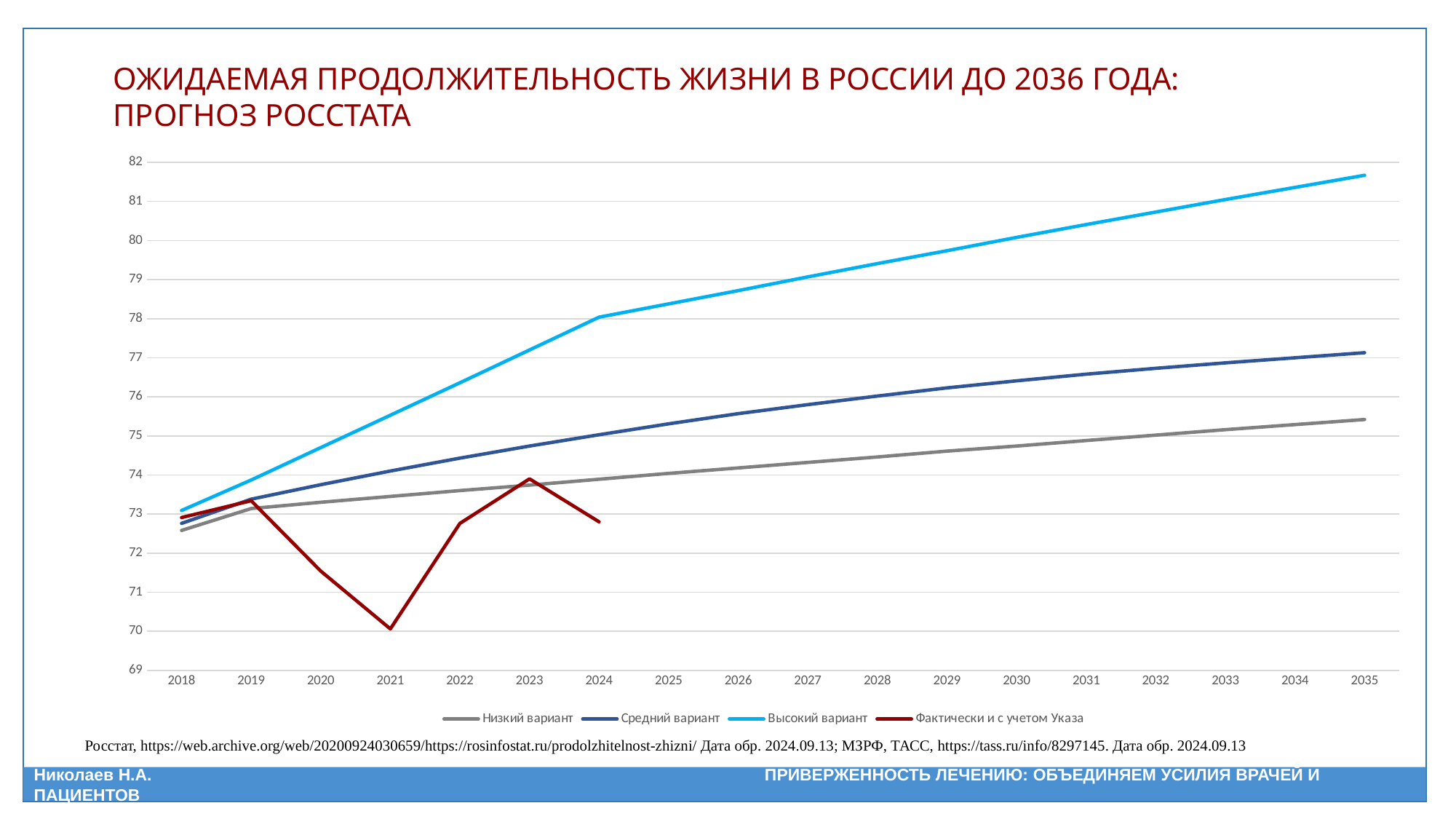
Which series has the highest value in 2035? Высокий вариант Is the value for 'Средний вариант' in 2035 greater or less than 78? less In which year does the series 'Фактически и с учетом Указа' reach its highest value? 2023 How many years are shown on the x axis? 18 What colour is the line for 'Фактически и с учетом Указа'? dark red In 2021, which is larger: 'Низкий вариант' or 'Фактически и с учетом Указа'? Низкий вариант In which year does the series 'Фактически и с учетом Указа' reach its lowest value? 2021 Does the 'Высокий вариант' series rise or fall from 2018 to 2035? rises How many series does the legend list? 4 Is the value for 'Фактически и с учетом Указа' in 2021 greater or less than 71? less What kind of chart is shown on the slide? line chart Is the value for 'Высокий вариант' in 2035 greater or less than 81? greater